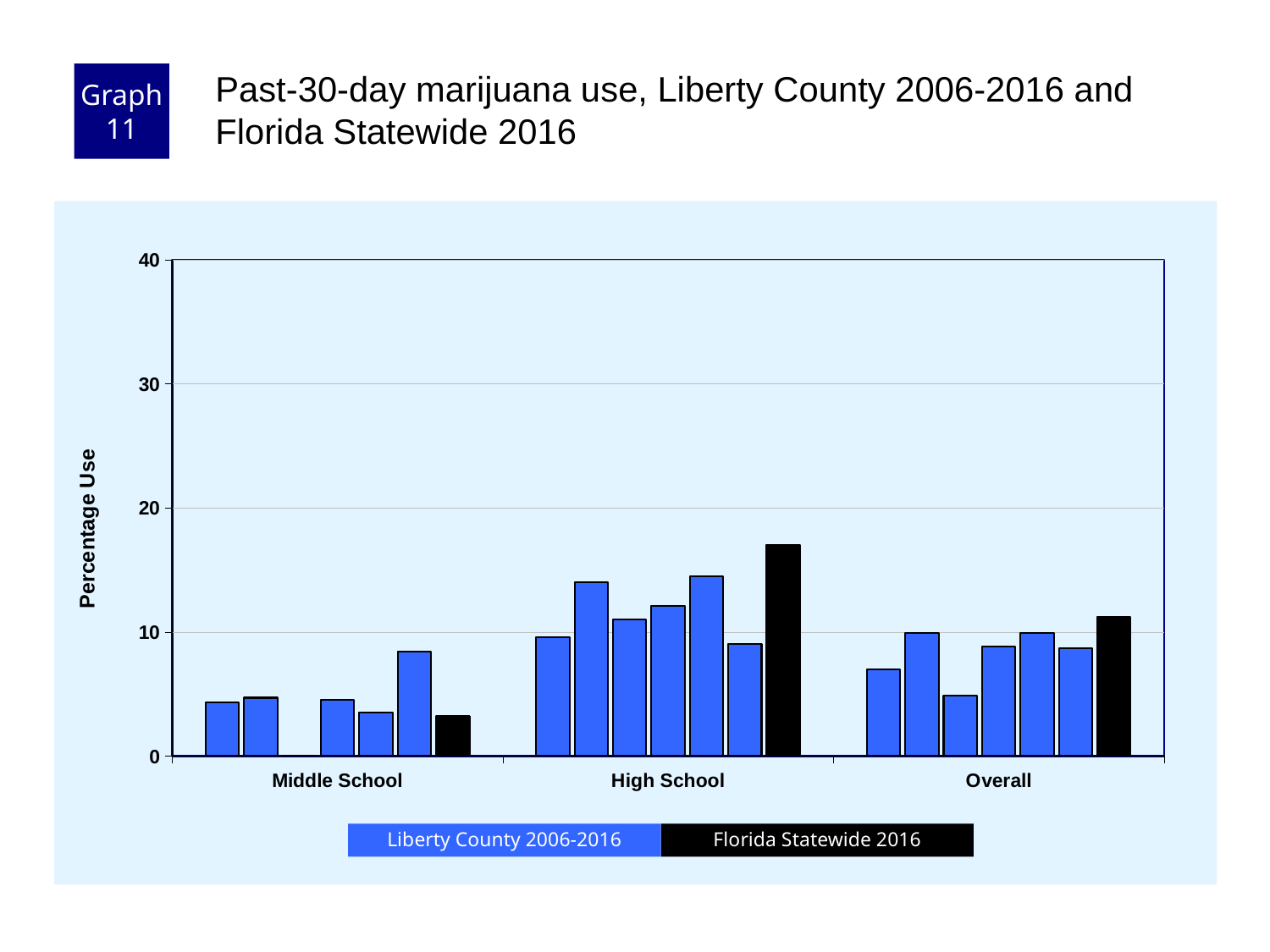
How many series does the legend list? 2 Is the Florida Statewide 2016 value for High School greater or less than 10? greater What is the label of the y axis? Percentage Use How many categories are shown on the x axis? 3 In which category does the tallest bar on the chart appear? High School Which is larger, the Florida Statewide 2016 value for High School or for Overall? High School Which category has the highest Florida Statewide 2016 value? High School Is the Florida Statewide 2016 value for Overall greater or less than 20? less What are the two series named in the legend? Liberty County 2006-2016 and Florida Statewide 2016 What kind of chart is shown on the slide? bar chart Which category has the lowest Florida Statewide 2016 value? Middle School Is the Florida Statewide 2016 value for Middle School greater or less than 10? less